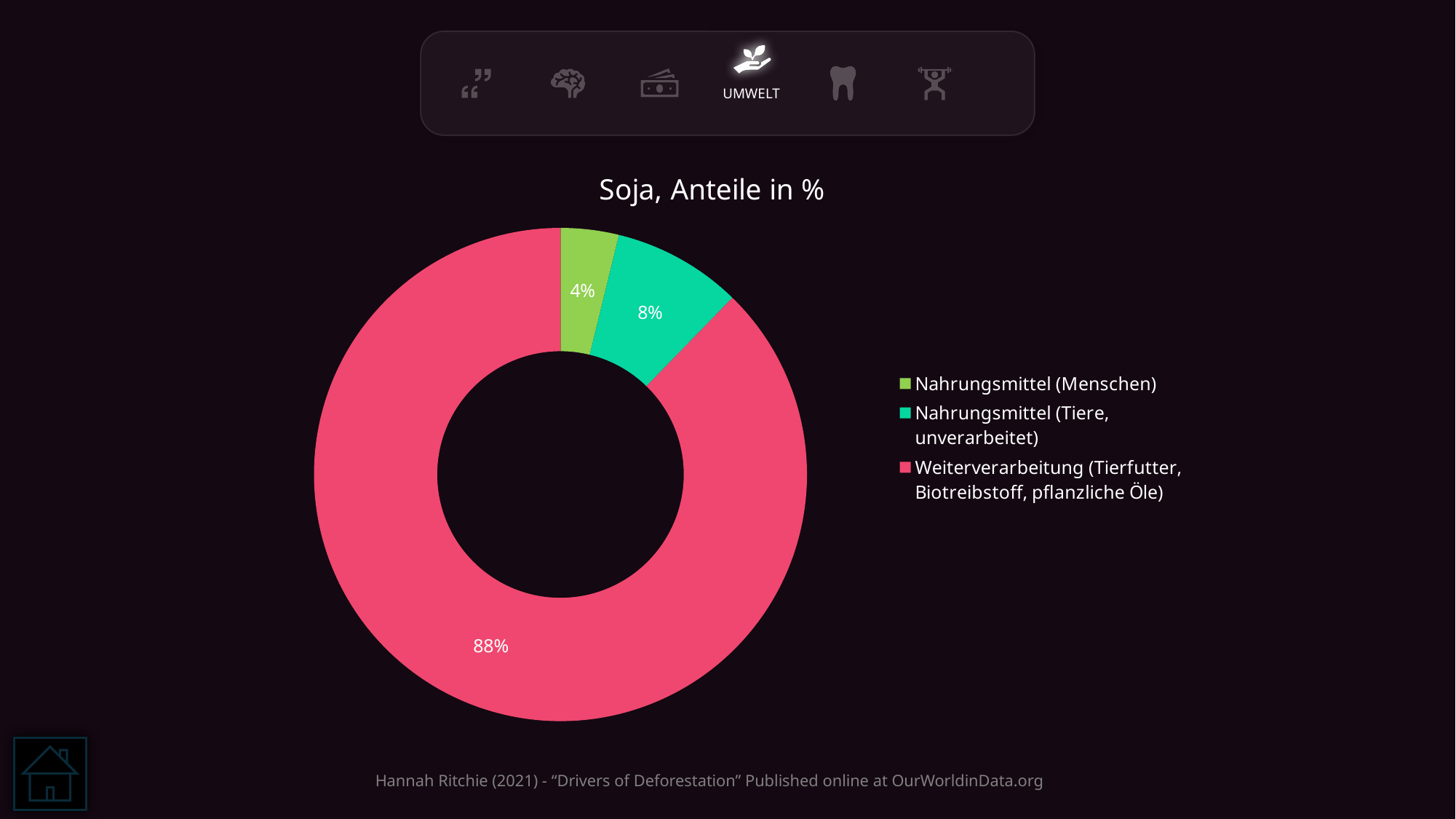
Which is larger: the share for Nahrungsmittel (Menschen) or for Nahrungsmittel (Tiere, unverarbeitet)? Nahrungsmittel (Tiere, unverarbeitet) What is the title of the chart? Soja, Anteile in % Which category has the largest share? Weiterverarbeitung (Tierfutter, Biotreibstoff, pflanzliche Öle) How many categories does the chart show? 3 What share does Weiterverarbeitung (Tierfutter, Biotreibstoff, pflanzliche Öle) have? 88% What colour is the slice for Nahrungsmittel (Menschen)? Green Which category has the smallest share? Nahrungsmittel (Menschen) What share does Nahrungsmittel (Tiere, unverarbeitet) have? 8% What is the difference in percentage points between Weiterverarbeitung and Nahrungsmittel (Tiere, unverarbeitet)? 80 percentage points What share does Nahrungsmittel (Menschen) have? 4% What kind of chart is shown on the slide? Pie chart (doughnut) What is the difference in percentage points between Nahrungsmittel (Tiere, unverarbeitet) and Nahrungsmittel (Menschen)? 4 percentage points